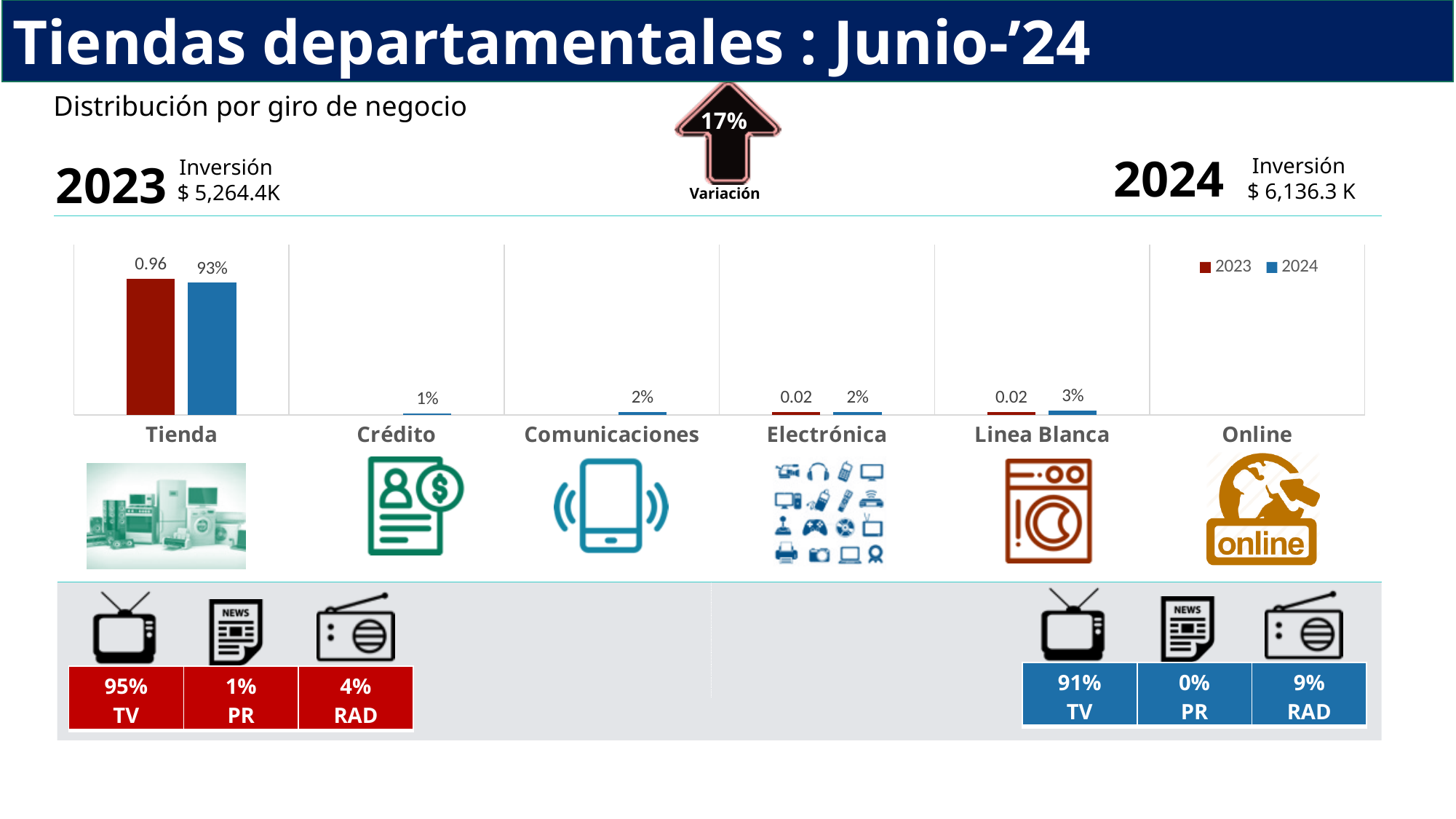
What kind of chart is shown on the slide? bar chart What is the 2023 value for Electrónica in the chart? 0.02 What is the 2024 value for Linea Blanca in the chart? 3% Which is larger in the chart: the 2024 value for Linea Blanca or the 2024 value for Crédito? Linea Blanca What is the 2023 value for Tienda in the chart? 0.96 What is the 2024 value for Crédito in the chart? 1% Which category has the highest 2024 value in the chart? Tienda How many series does the chart legend list? 2 What is the 2024 value for Comunicaciones in the chart? 2% Which colour represents the 2023 series in the chart legend? red How many categories are shown along the x axis of the chart? 6 What is the 2024 value for Tienda in the chart? 93%